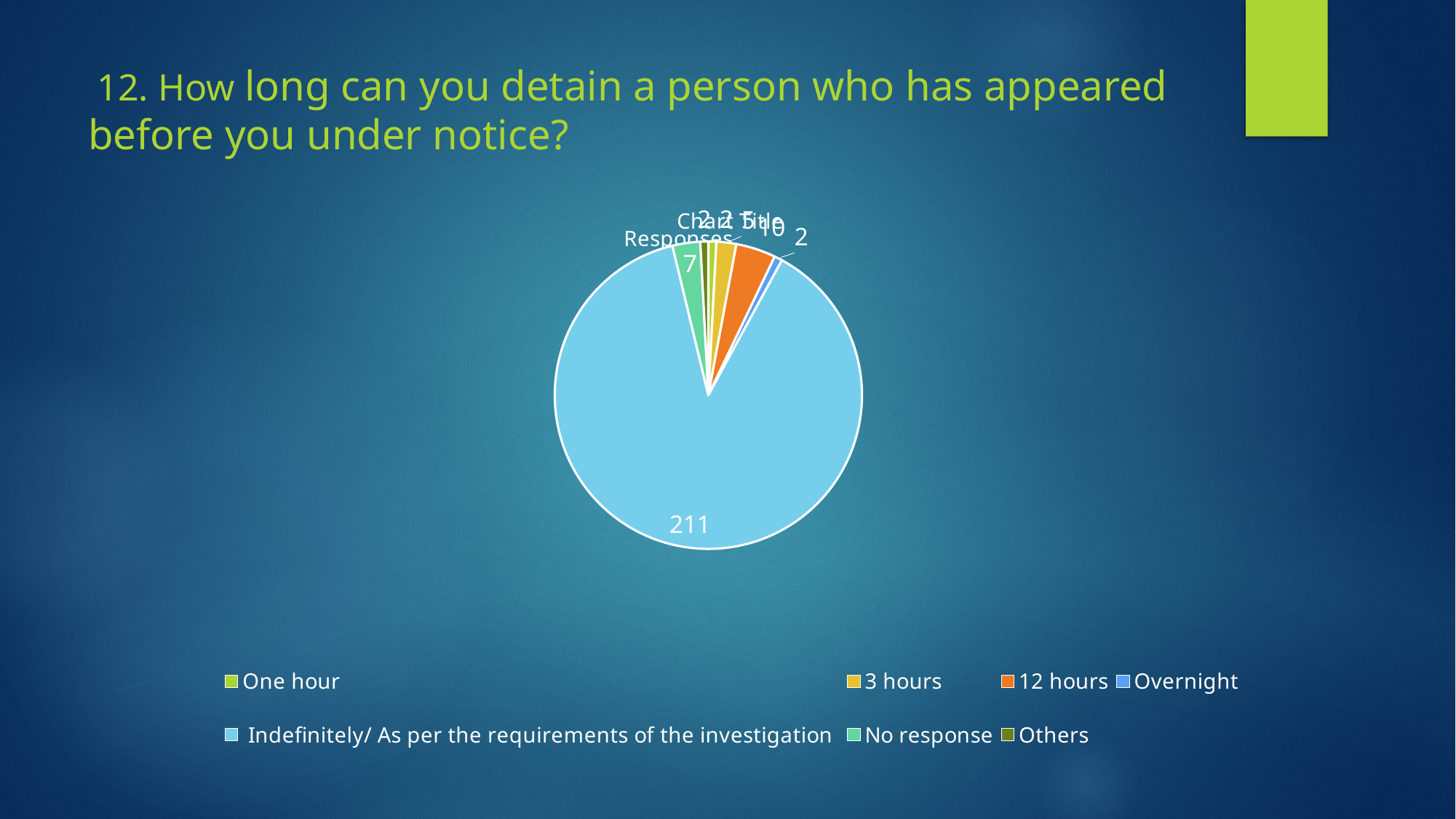
What is the difference between the values for '12 hours' and 'No response'? 3 What is the value for 'No response' in the pie chart? 7 Which is larger, the value for 'No response' or the value for 'Overnight'? No response What kind of chart is shown on the slide? Pie chart How many categories does the legend of the pie chart list? 7 What colour is the slice for 'Indefinitely/ As per the requirements of the investigation'? Light blue What is the value for 'Indefinitely/ As per the requirements of the investigation' in the pie chart? 211 Which is larger, the value for '12 hours' or the value for 'No response'? 12 hours What is the value for '12 hours' in the pie chart? 10 Which category has the largest slice in the pie chart? Indefinitely/ As per the requirements of the investigation What is the value for 'Overnight' in the pie chart? 2 What is the difference between the values for 'Indefinitely/ As per the requirements of the investigation' and '12 hours'? 201